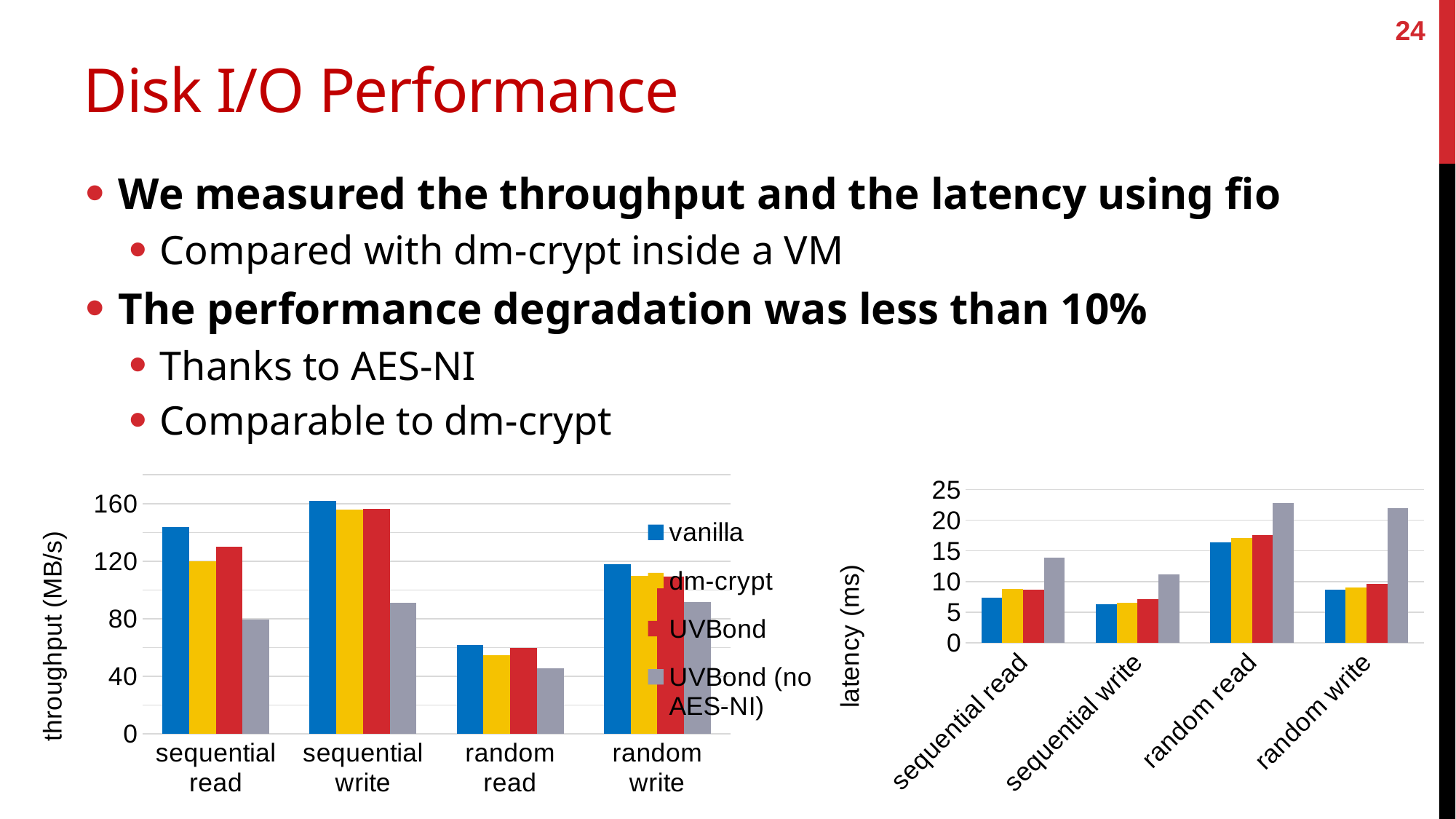
In the latency chart on the right, is the UVBond (no AES-NI) value for random write greater or less than 20? greater In the throughput chart on the left, which category has the lowest vanilla throughput? random read In the throughput chart on the left, how many series does the legend list? 4 What is the y-axis label of the latency chart on the right? latency (ms) In the throughput chart on the left, how many workload categories are shown on the x axis? 4 In the latency chart on the right, is the vanilla value for random read greater or less than 15? greater In the throughput chart on the left, is the UVBond (no AES-NI) value for sequential read greater or less than 120? less What kind of chart is the throughput chart on the left of the slide? bar chart In the throughput chart on the left, which category has the highest vanilla throughput? sequential write In the latency chart on the right, which category has the highest vanilla latency? random read In the throughput chart on the left, for sequential read, which is larger: vanilla or dm-crypt? vanilla